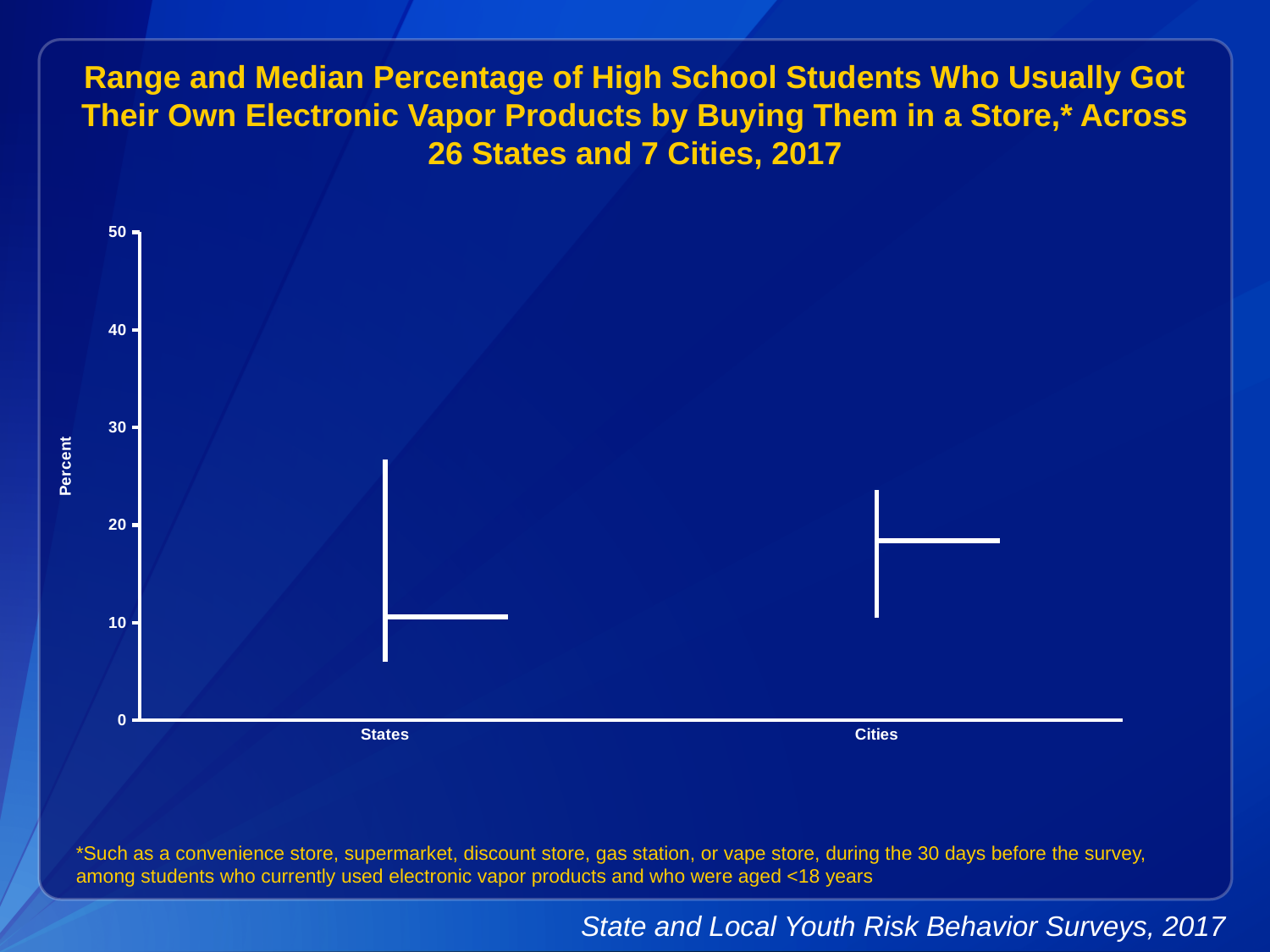
What is the highest value shown on the y axis of the chart? 50 What is the label on the y axis of the chart? Percent What are the two categories shown on the x axis? States and Cities Which category has the higher median value, States or Cities? Cities Is the top of the range for States greater or less than 20? greater Which category shows the wider range of values, States or Cities? States How many categories are shown on the x axis of the chart? 2 Is the bottom of the range for States greater or less than 10? less Is the median value for Cities greater or less than 10? greater Which category has the higher maximum value in its range, States or Cities? States